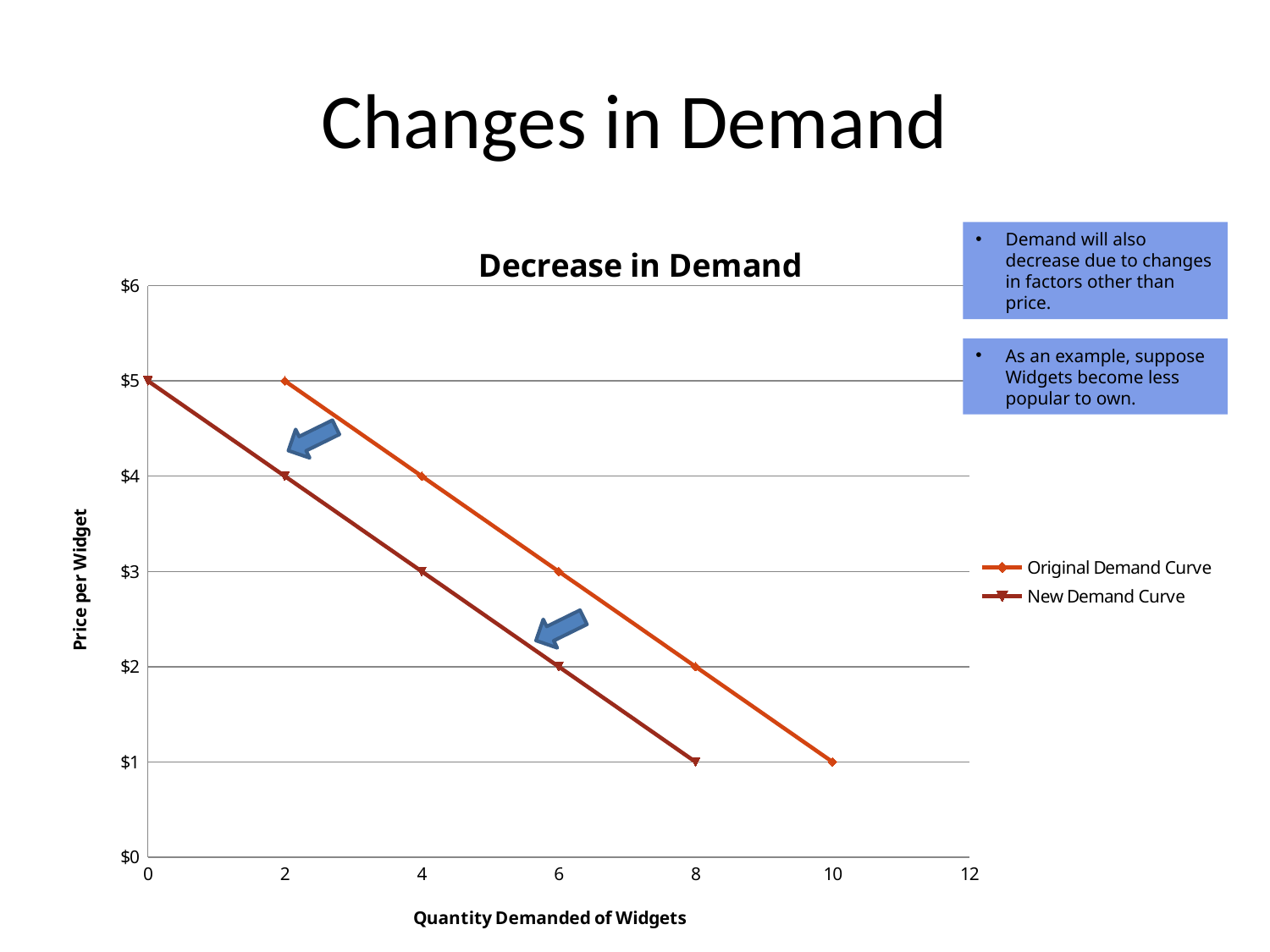
On the Original Demand Curve, what quantity is demanded at a price of $1? 10 On the New Demand Curve, what is the price when the quantity demanded is 0? $5 As quantity demanded increases along the x axis, does the price on the Original Demand Curve rise or fall? Fall At a price of $4, which series shows the larger quantity demanded, the Original Demand Curve or the New Demand Curve? Original Demand Curve On the Original Demand Curve, what quantity is demanded at a price of $3? 6 On the New Demand Curve, what quantity is demanded at a price of $3? 4 What kind of chart is shown on the slide? Line chart How many data points are plotted on the Original Demand Curve? 5 How many series does the chart legend list? 2 What is the label of the vertical axis? Price per Widget At a price of $2, what is the difference in quantity demanded between the Original Demand Curve and the New Demand Curve? 2 What is the title of the chart? Decrease in Demand